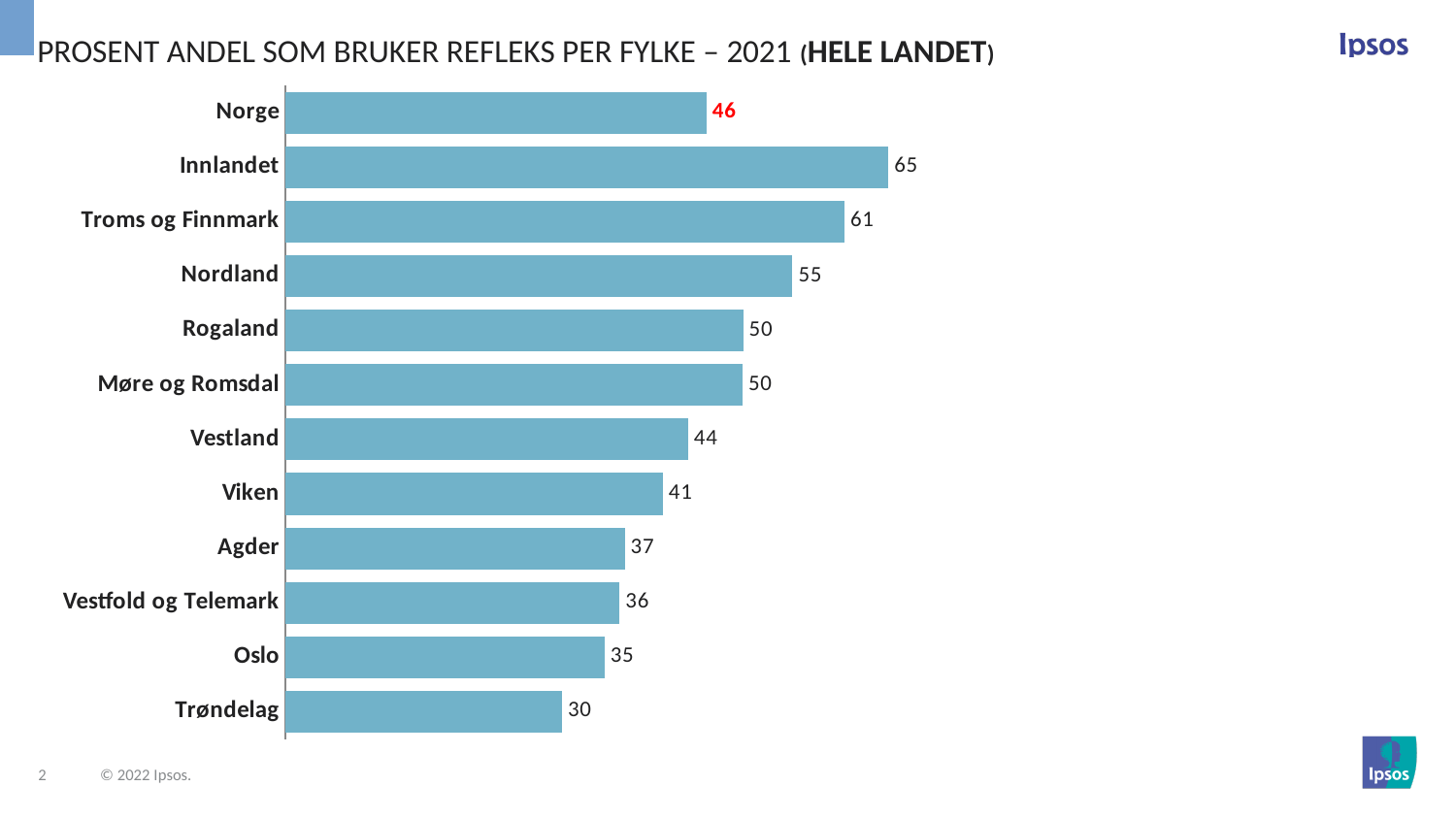
What is the value for Innlandet? 65 Which is larger, the value for Oslo or the value for Agder? Agder What is the difference between the values for Innlandet and Trøndelag? 35 How many categories are shown in the chart? 12 What kind of chart is shown on the slide? Bar chart What is the value for Trøndelag? 30 Which category's data label is shown in red? Norge What is the difference between the values for Troms og Finnmark and Nordland? 6 What is the value for Norge? 46 Which category has the highest value? Innlandet Which is larger, the value for Vestland or the value for Viken? Vestland Which category has the lowest value? Trøndelag